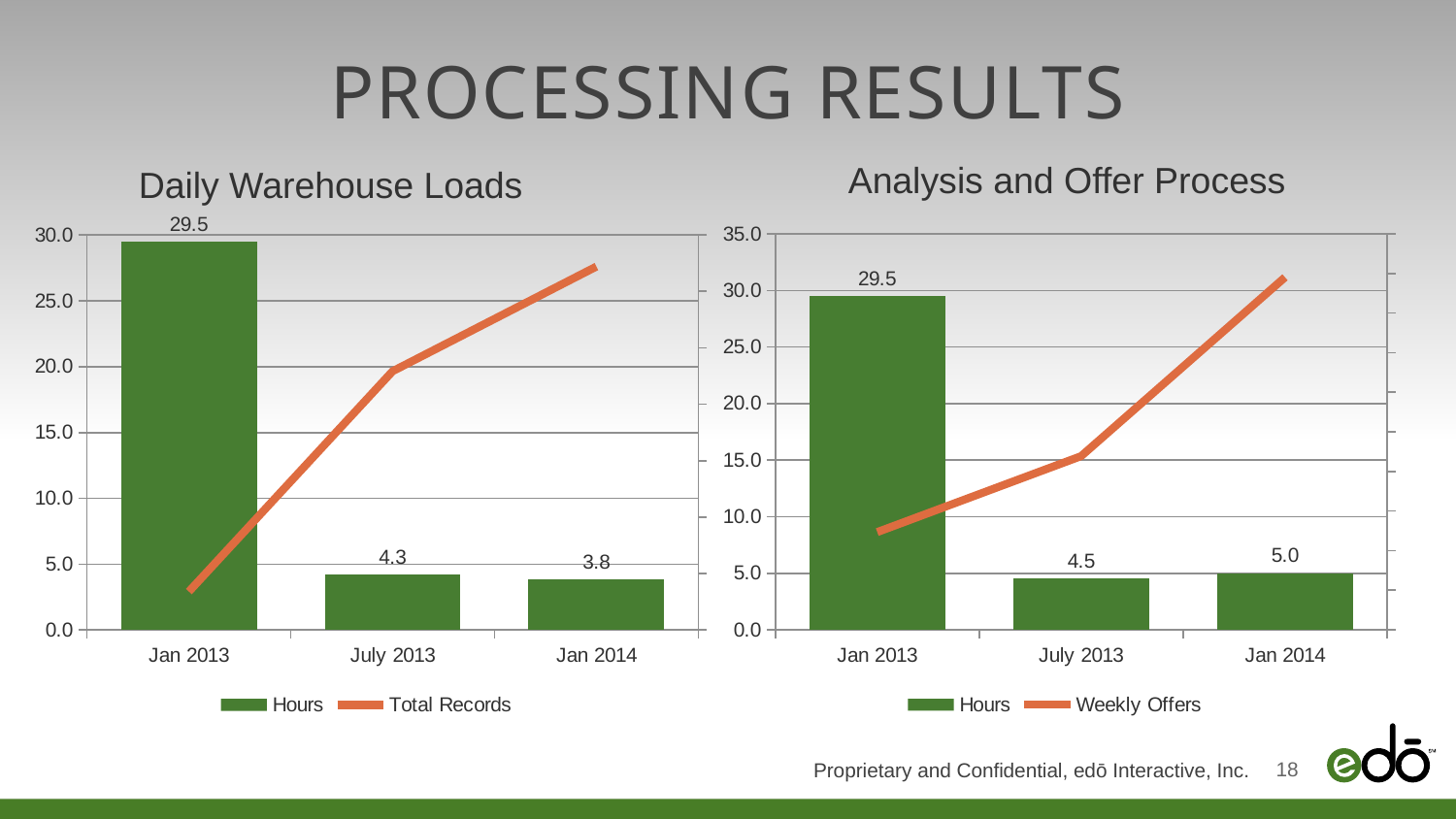
In the Daily Warehouse Loads chart, does the Total Records line rise or fall from Jan 2013 to Jan 2014? rise In the Analysis and Offer Process chart, how many periods are shown on the x axis? 3 In the Analysis and Offer Process chart, is the Hours value for July 2013 or Jan 2014 larger? Jan 2014 In the Analysis and Offer Process chart, what is the Hours value for July 2013? 4.5 In the Daily Warehouse Loads chart, which period has the lowest Hours value? Jan 2014 In the Daily Warehouse Loads chart, what is the Hours value for Jan 2013? 29.5 In the Analysis and Offer Process chart, which period has the highest Hours value? Jan 2013 In the Daily Warehouse Loads chart, what is the Hours value for Jan 2014? 3.8 In the Analysis and Offer Process chart, what is the name of the series drawn as an orange line? Weekly Offers In the Daily Warehouse Loads chart, what is the difference in Hours between Jan 2013 and July 2013? 25.2 In the Daily Warehouse Loads chart, how many series does the legend list? 2 In the Analysis and Offer Process chart, what is the Hours value for Jan 2014? 5.0